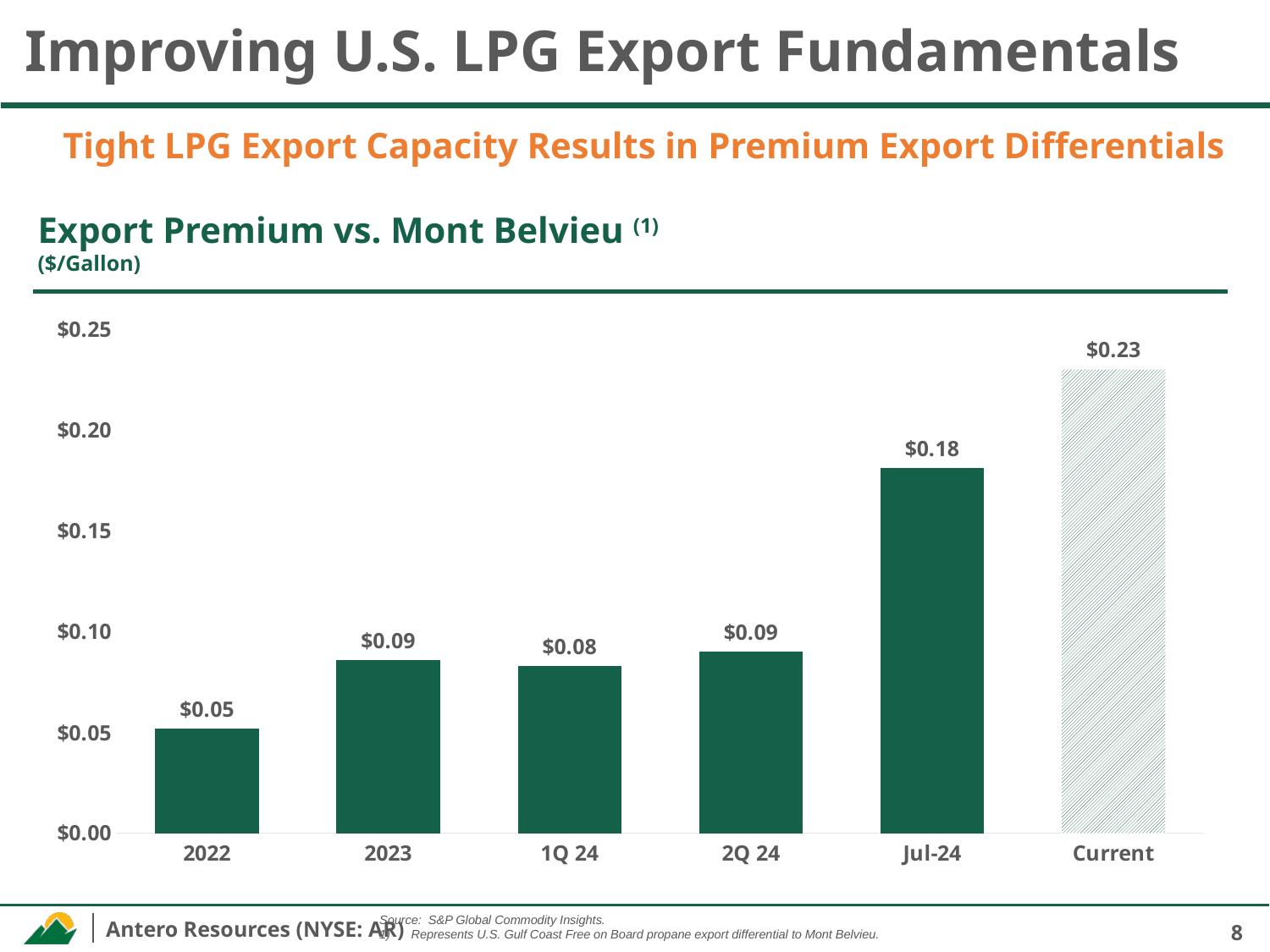
What kind of chart is shown on the slide? Bar chart Is the value for Jul-24 greater or less than $0.15? greater Which is larger, the export premium for 2Q 24 or for Jul-24? Jul-24 What is the difference between the Current export premium and the Jul-24 export premium? $0.05 What is the export premium vs. Mont Belvieu for Jul-24? $0.18 What is the Current export premium vs. Mont Belvieu? $0.23 How many categories are shown on the x axis of the chart? 6 What is the export premium vs. Mont Belvieu for 1Q 24? $0.08 What is the difference between the 2023 export premium and the 2022 export premium? $0.04 What is the export premium vs. Mont Belvieu for 2022? $0.05 Which category has the highest export premium vs. Mont Belvieu? Current Which category has the lowest export premium vs. Mont Belvieu? 2022